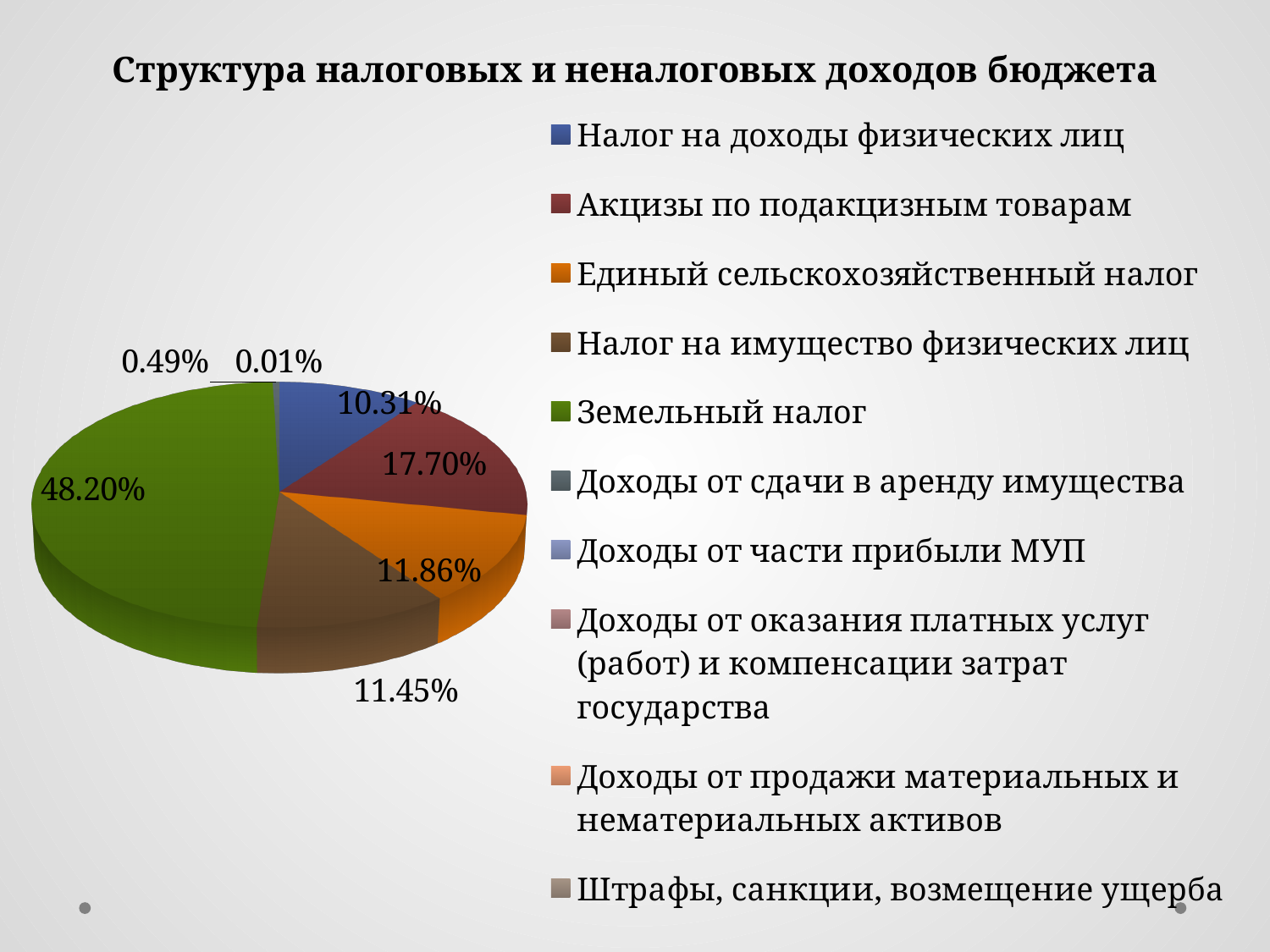
What is the value for Единый сельскохозяйственный налог? 11.86% What share of the pie does Земельный налог have? 48.20% What percentage is shown for Налог на доходы физических лиц? 10.31% What kind of chart is shown on the slide? Pie chart Which category has the largest slice of the pie? Земельный налог What is the difference between the shares of Земельный налог and Акцизы по подакцизным товарам? 30.50% What percentage is shown for Налог на имущество физических лиц? 11.45% How many entries does the legend of the pie chart list? 10 What is the value shown for Акцизы по подакцизным товарам? 17.70% Which is larger: the share of Единый сельскохозяйственный налог or Налог на имущество физических лиц? Единый сельскохозяйственный налог By how much does Акцизы по подакцизным товарам exceed Налог на доходы физических лиц? 7.39% What is the title of the chart? Структура налоговых и неналоговых доходов бюджета